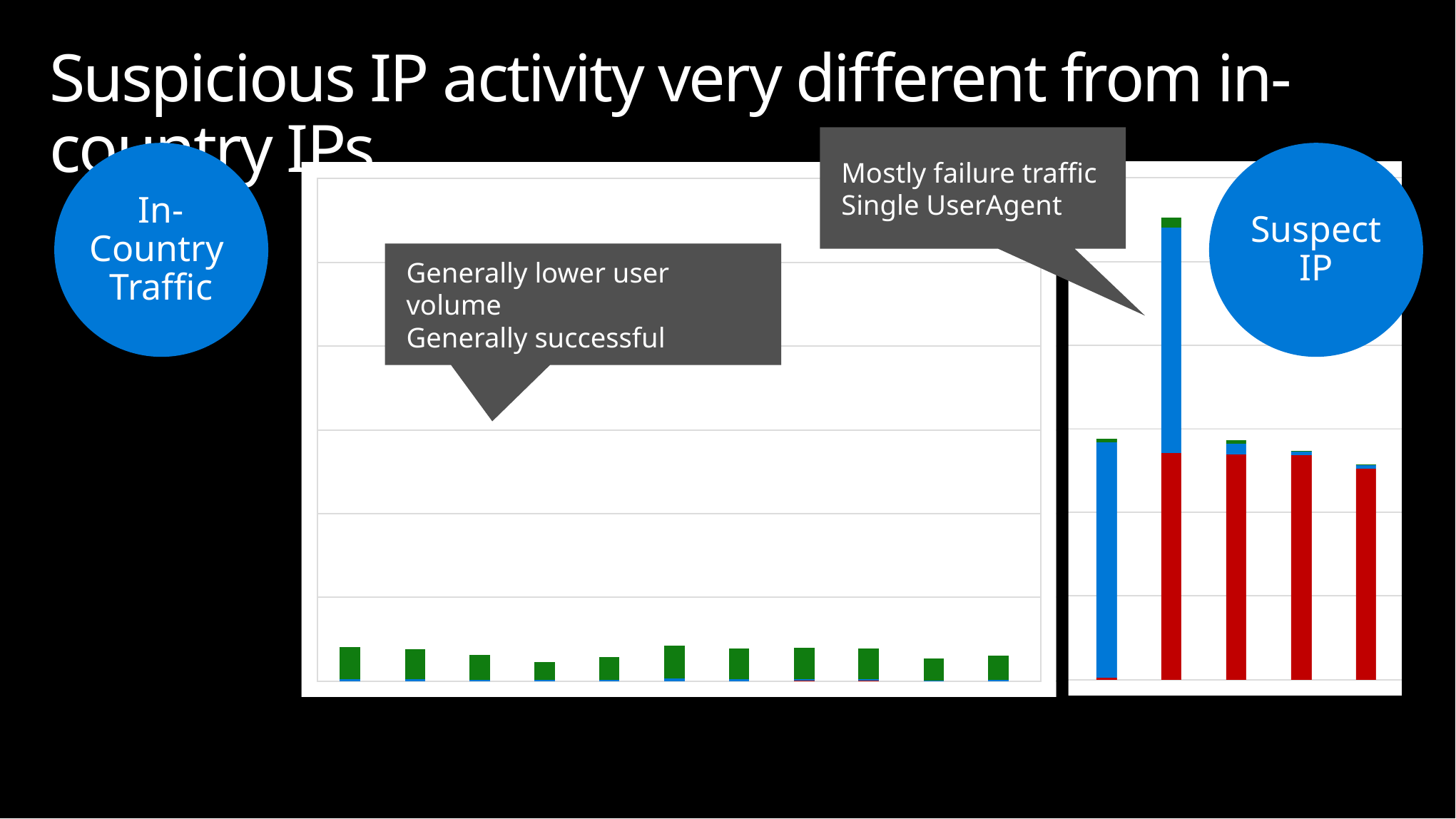
In the Suspect IP chart on the right, which bar is the tallest? the second bar How many bars are plotted in the Suspect IP chart on the right? 5 What kind of chart is the In-Country Traffic chart on the left? bar chart Which colour makes up most of each bar in the In-Country Traffic chart on the left? green What kind of chart is the Suspect IP chart on the right? bar chart In the In-Country Traffic chart on the left, is the sixth bar taller or shorter than the fourth bar? taller Which chart has taller bars overall, the In-Country Traffic chart on the left or the Suspect IP chart on the right? the Suspect IP chart on the right Which colour makes up most of the bars in the Suspect IP chart on the right? red In the Suspect IP chart on the right, which bar is the shortest? the fifth (last) bar How many bars are plotted in the In-Country Traffic chart on the left? 11